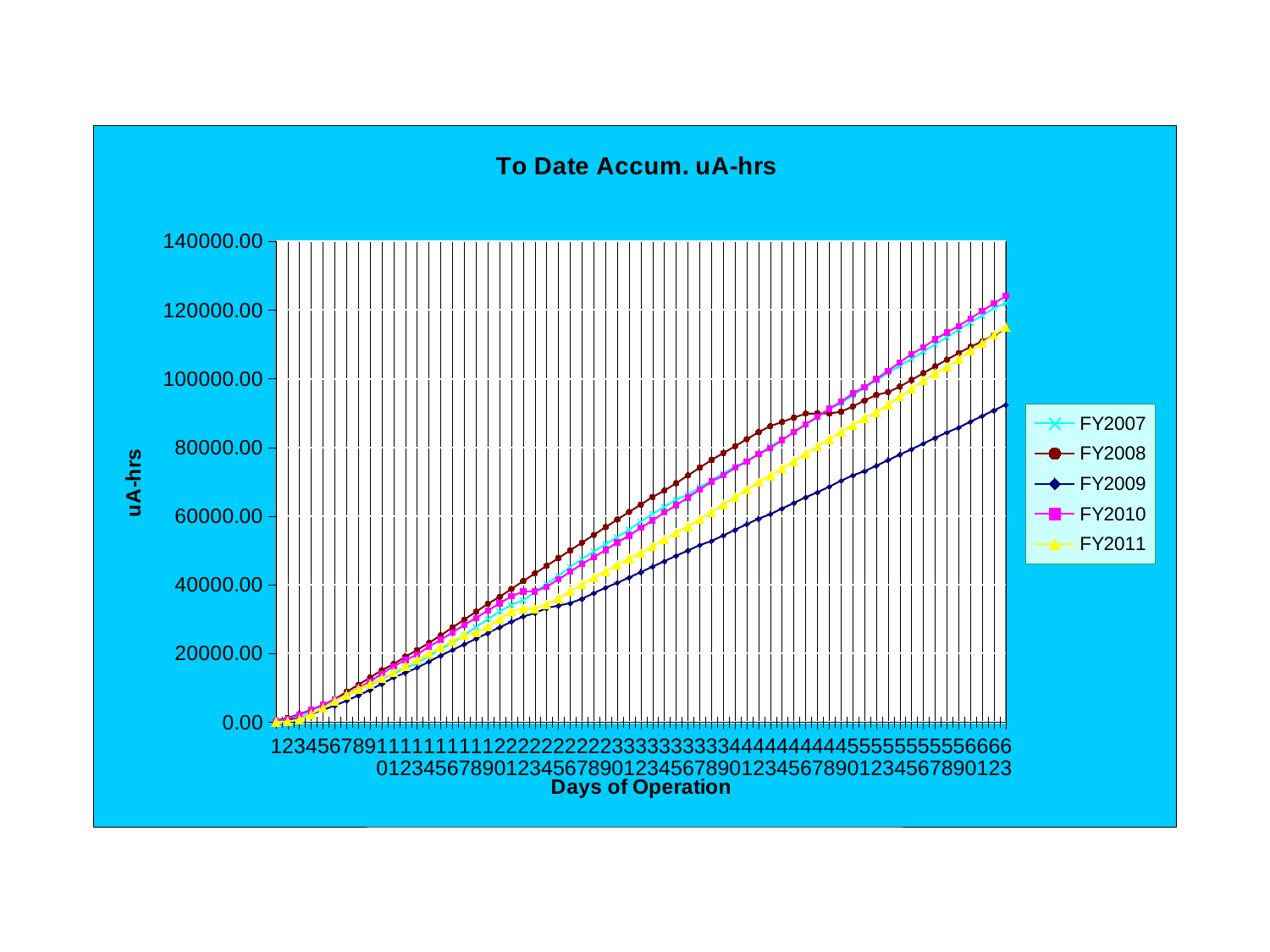
What is the title of the chart? To Date Accum. uA-hrs At the last day of operation, is the value for FY2009 greater or less than 100000.00? less What is the label of the x axis? Days of Operation At the last day of operation, is the value for FY2010 greater or less than 120000.00? greater How many series does the legend list? 5 At the last day of operation, which is larger, the value for FY2010 or the value for FY2009? FY2010 Which series has the lowest accumulated uA-hrs at the last day of operation? FY2009 At the last day of operation, which is larger, the value for FY2008 or the value for FY2009? FY2008 At the last day of operation, is the value for FY2011 greater or less than 100000.00? greater What kind of chart is shown on the slide? line chart What is the highest value shown on the y axis? 140000.00 Do the values for FY2009 rise or fall as the days of operation increase? rise